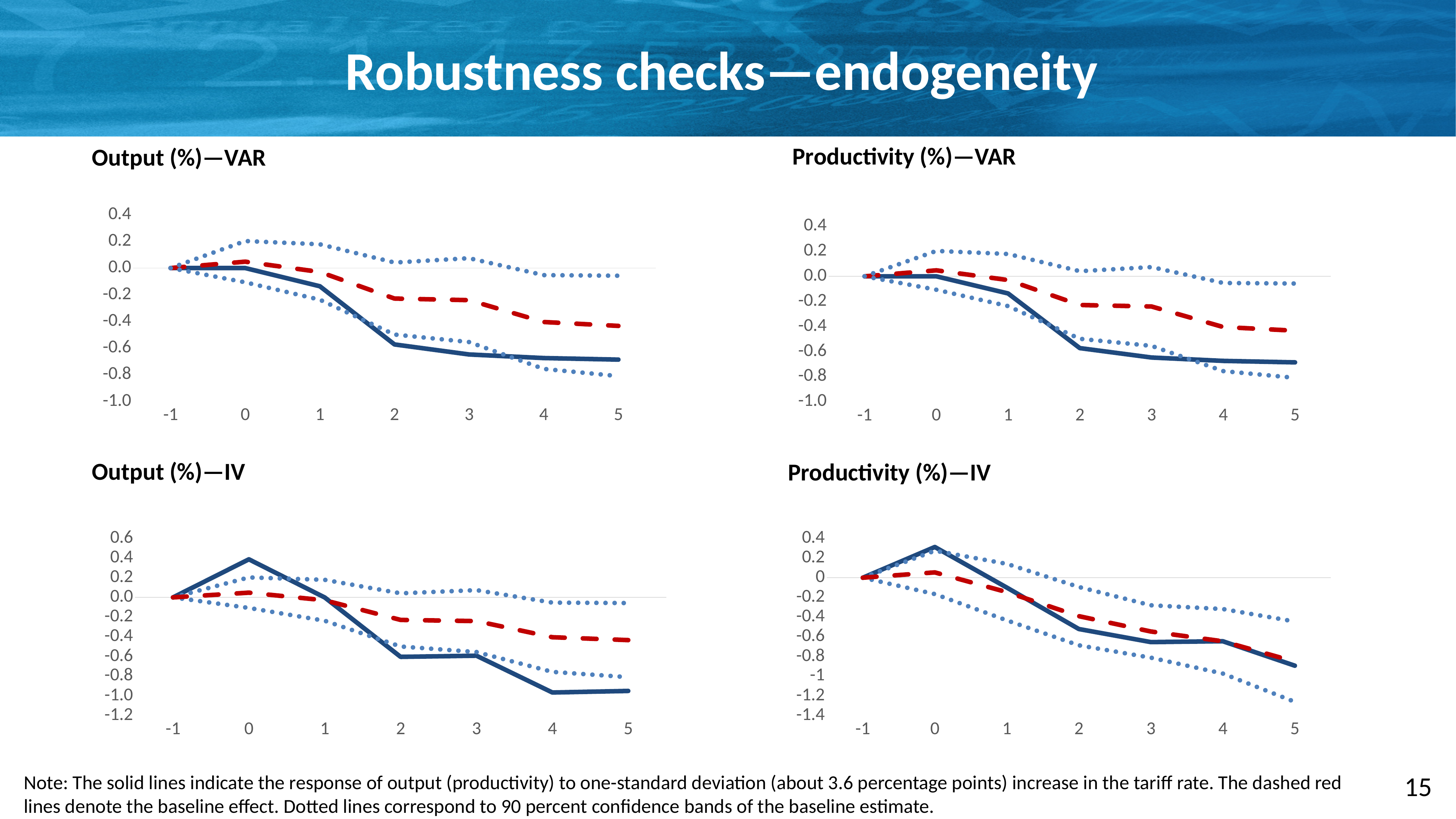
In the Output (%)—IV chart, how many points are labelled on the x axis? 7 In the Output (%)—IV chart, is the solid line value at period 4 greater or less than -0.8? less In the Output (%)—VAR chart, does the solid line rise or fall from period 0 to period 5? fall In the Output (%)—IV chart, at which period does the solid line reach its highest value? 0 In the Productivity (%)—VAR chart, is the solid line value at period 5 greater or less than -0.6? less What kind of chart is the Output (%)—VAR chart? line chart In the Productivity (%)—IV chart, is the solid line value higher at period 0 or at period 5? period 0 How many charts are shown on the slide? 4 In the Output (%)—VAR chart, is the solid line value at period 5 greater or less than -0.6? less What colour is the dashed line in the Productivity (%)—VAR chart? red